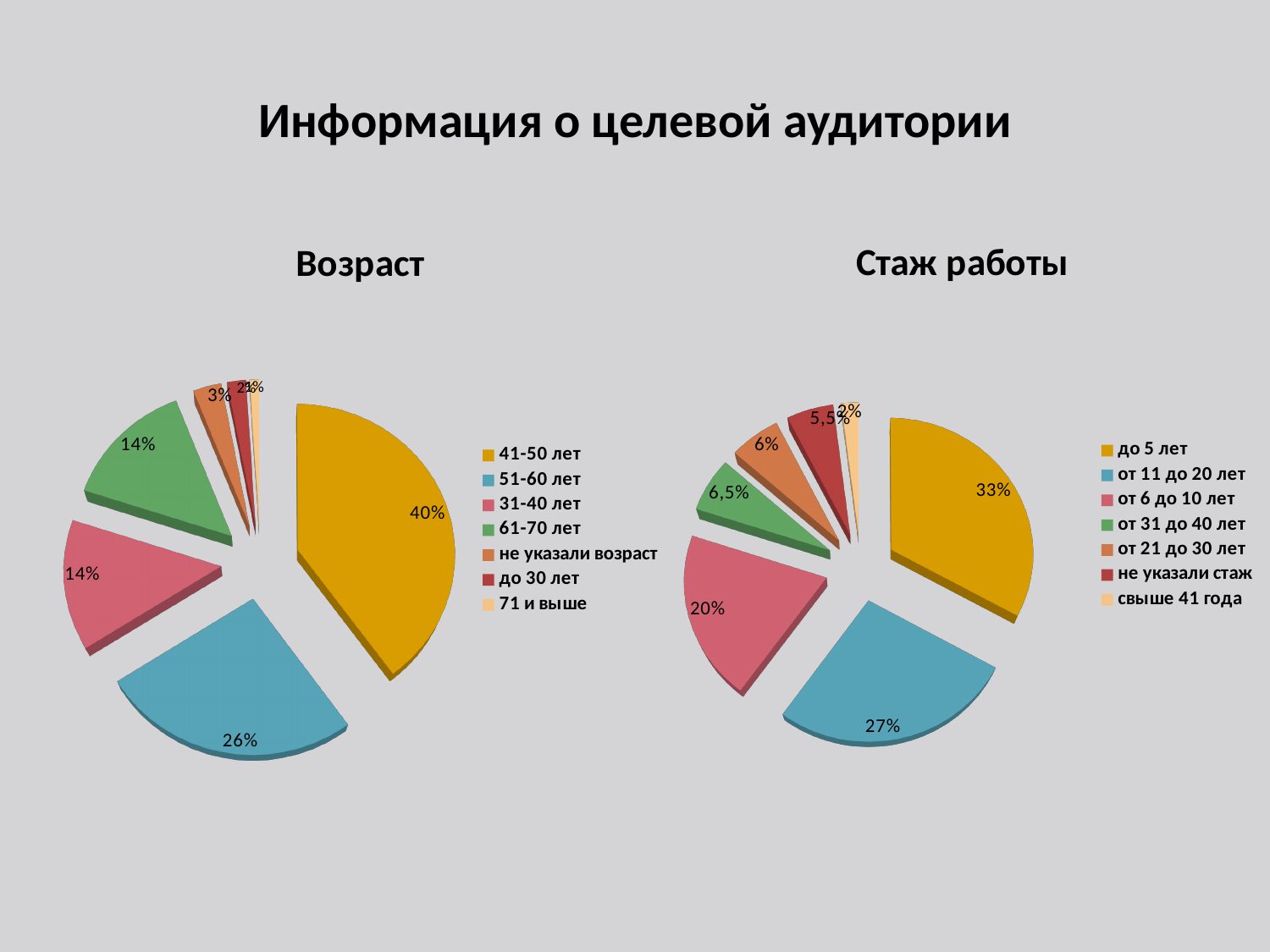
On the Стаж работы chart, what share is the от 6 до 10 лет slice? 20% On the Возраст chart, how many categories does the legend list? 7 On the Стаж работы chart, what share is the до 5 лет slice? 33% On the Стаж работы chart, what is the difference between the до 5 лет and от 11 до 20 лет slices? 6% On the Возраст chart, which category has the largest slice? 41-50 лет On the Стаж работы chart, what share is the от 31 до 40 лет slice? 6,5% On the Стаж работы chart, what colour is the до 5 лет slice? Yellow (gold) On the Стаж работы chart, which is larger: от 11 до 20 лет or от 6 до 10 лет? от 11 до 20 лет On the Возраст chart, what is the difference between the 41-50 лет and 51-60 лет slices? 14% What kind of chart is the Возраст chart? Pie chart On the Возраст chart, what share is the 41-50 лет slice? 40% On the Возраст chart, what share is the 51-60 лет slice? 26%